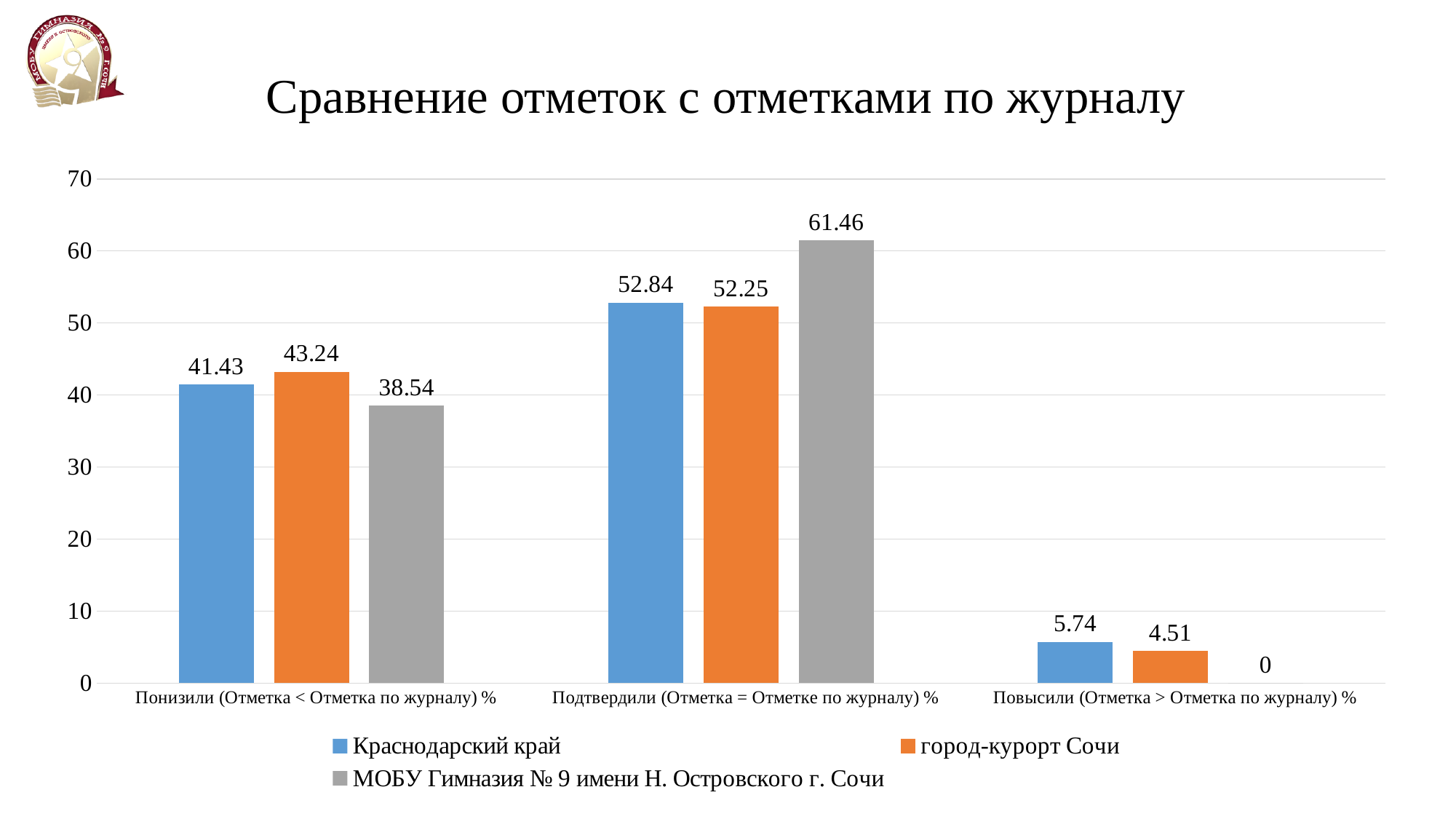
What is the value for МОБУ Гимназия № 9 имени Н. Островского г. Сочи in the Повысили (Отметка > Отметка по журналу) % category? 0 Which series has the lowest value in the Понизили (Отметка < Отметка по журналу) % category? МОБУ Гимназия № 9 имени Н. Островского г. Сочи In the Понизили (Отметка < Отметка по журналу) % category, which is larger: Краснодарский край or город-курорт Сочи? город-курорт Сочи What is the difference between the МОБУ Гимназия № 9 value and the Краснодарский край value in the Подтвердили (Отметка = Отметке по журналу) % category? 8.62 What kind of chart is shown on the slide? bar chart Is the value for Краснодарский край in the Повысили (Отметка > Отметка по журналу) % category greater or less than 10? less How many series does the legend list? 3 What is the value for МОБУ Гимназия № 9 имени Н. Островского г. Сочи in the Подтвердили (Отметка = Отметке по журналу) % category? 61.46 What is the value for Краснодарский край in the Понизили (Отметка < Отметка по журналу) % category? 41.43 What is the value for город-курорт Сочи in the Повысили (Отметка > Отметка по журналу) % category? 4.51 Which series has the highest value in the Подтвердили (Отметка = Отметке по журналу) % category? МОБУ Гимназия № 9 имени Н. Островского г. Сочи How many categories are shown on the x axis? 3